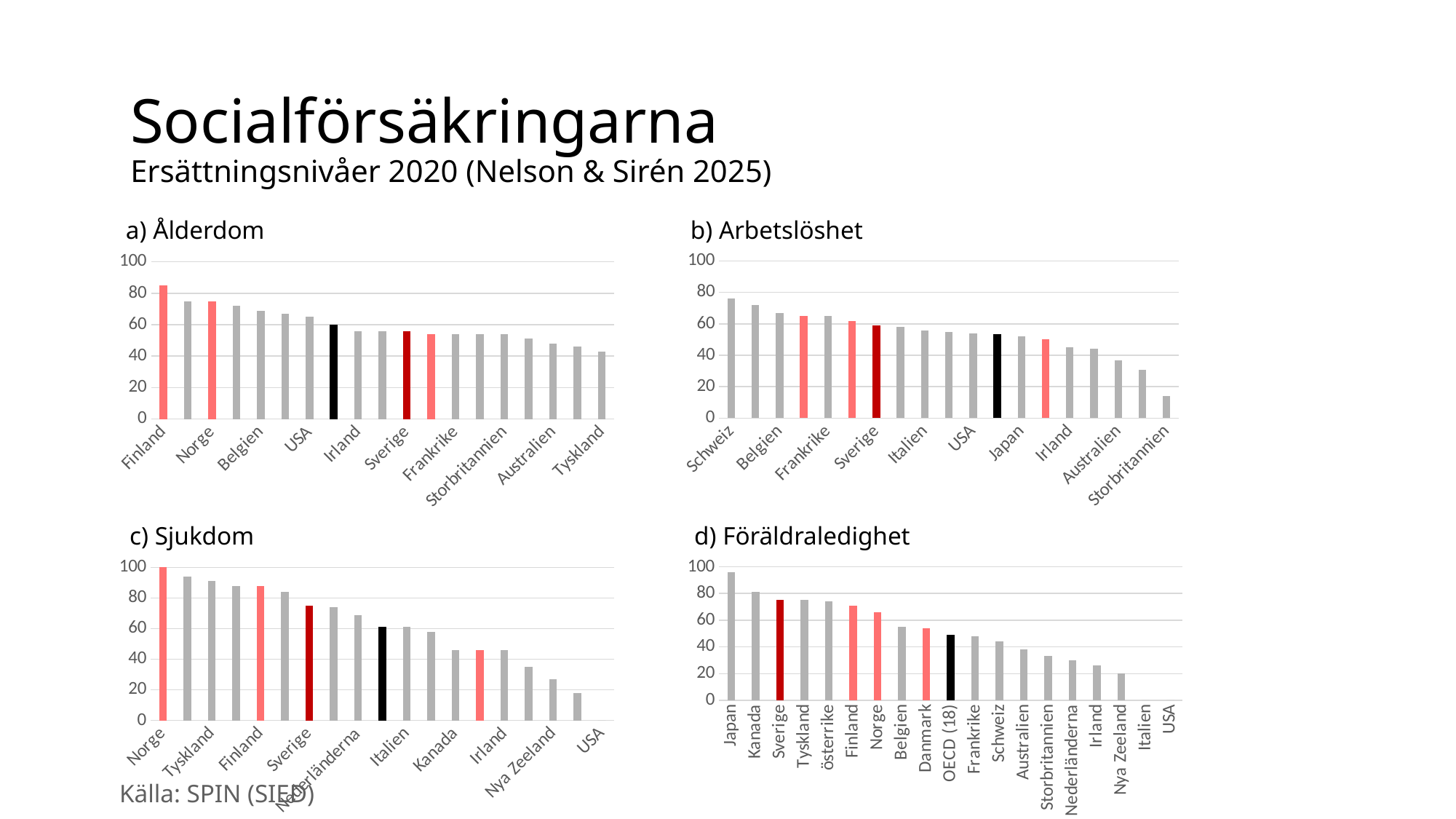
In the chart titled 'c) Sjukdom', do the values rise or fall from left to right along the x axis? fall In the chart titled 'c) Sjukdom', what is the value for Norge? 100 In the chart titled 'b) Arbetslöshet', which category has the lowest value? Storbritannien What kind of chart is the chart titled 'a) Ålderdom'? bar chart In the chart titled 'a) Ålderdom', which category has the highest value? Finland In the chart titled 'd) Föräldraledighet', which category has the highest value? Japan How many categories are shown on the x axis of the chart titled 'd) Föräldraledighet'? 19 In the chart titled 'd) Föräldraledighet', is the value for Nya Zeeland greater or less than 40? less In the chart titled 'a) Ålderdom', is the value for Finland greater or less than 80? greater In the chart titled 'c) Sjukdom', which category has the lowest value? USA In the chart titled 'b) Arbetslöshet', which is larger, the value for Schweiz or the value for Japan? Schweiz In the chart titled 'b) Arbetslöshet', is the value for Schweiz greater or less than 60? greater